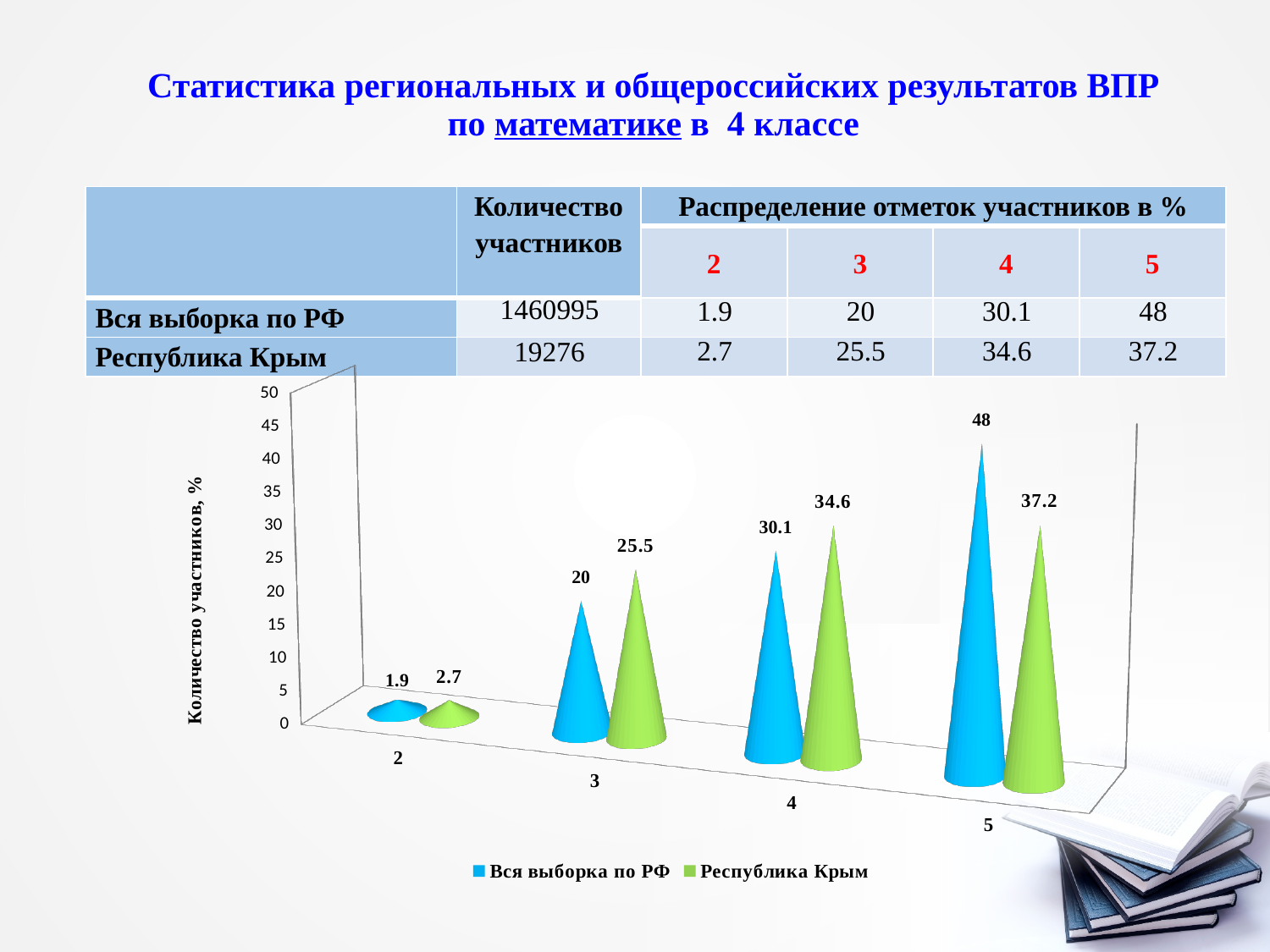
For grade 4, which series has the larger value: 'Вся выборка по РФ' or 'Республика Крым'? Республика Крым What is the value for grade 5 in the 'Вся выборка по РФ' series? 48 What kind of chart is shown on the slide? bar chart (3D cone-shaped bars) What is the value for grade 4 in the 'Вся выборка по РФ' series? 30.1 Which grade category has the highest value for 'Республика Крым'? 5 What is the value for grade 3 in the 'Республика Крым' series? 25.5 Is the value for grade 3 in the 'Республика Крым' series greater or less than 20? greater Do the values for 'Вся выборка по РФ' rise or fall as the grade increases from 2 to 5? rise How many grade categories are shown on the x axis of the chart? 4 How many series does the chart legend list? 2 What is the difference between the 'Вся выборка по РФ' and 'Республика Крым' values for grade 5? 10.8 Which grade category has the lowest value for 'Вся выборка по РФ'? 2